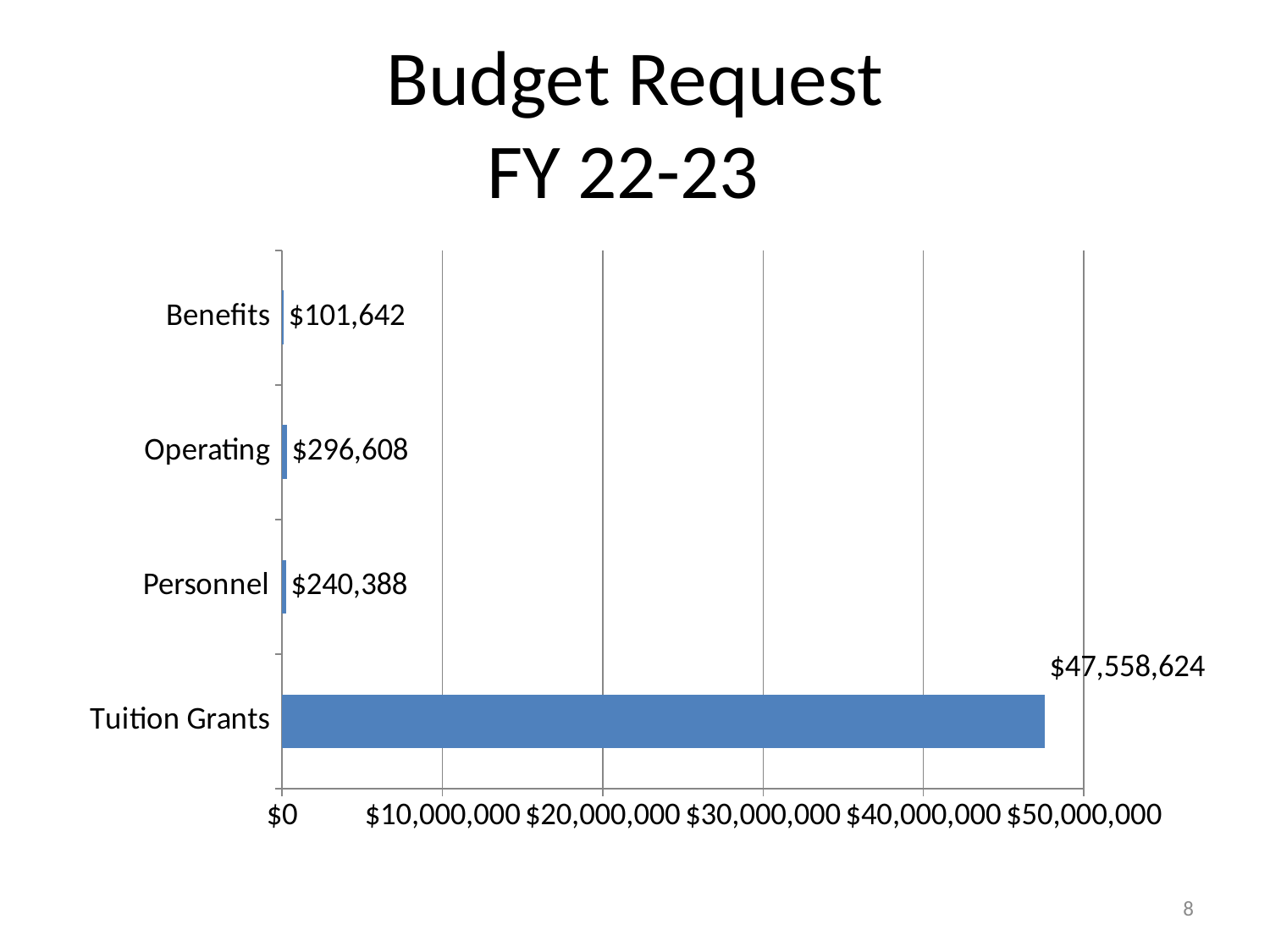
Which is larger, the value for Operating or the value for Personnel? Operating What is the value for Personnel? $240,388 Which category has the lowest value? Benefits Which category has the highest value? Tuition Grants How many categories are shown in the chart? 4 Is the value for Tuition Grants greater or less than $40,000,000? greater What is the difference between the Operating and Personnel values? $56,220 What is the value for Tuition Grants? $47,558,624 What is the difference between the Personnel and Benefits values? $138,746 What is the value for Operating? $296,608 What kind of chart is shown on the slide? Bar chart What is the value for Benefits? $101,642